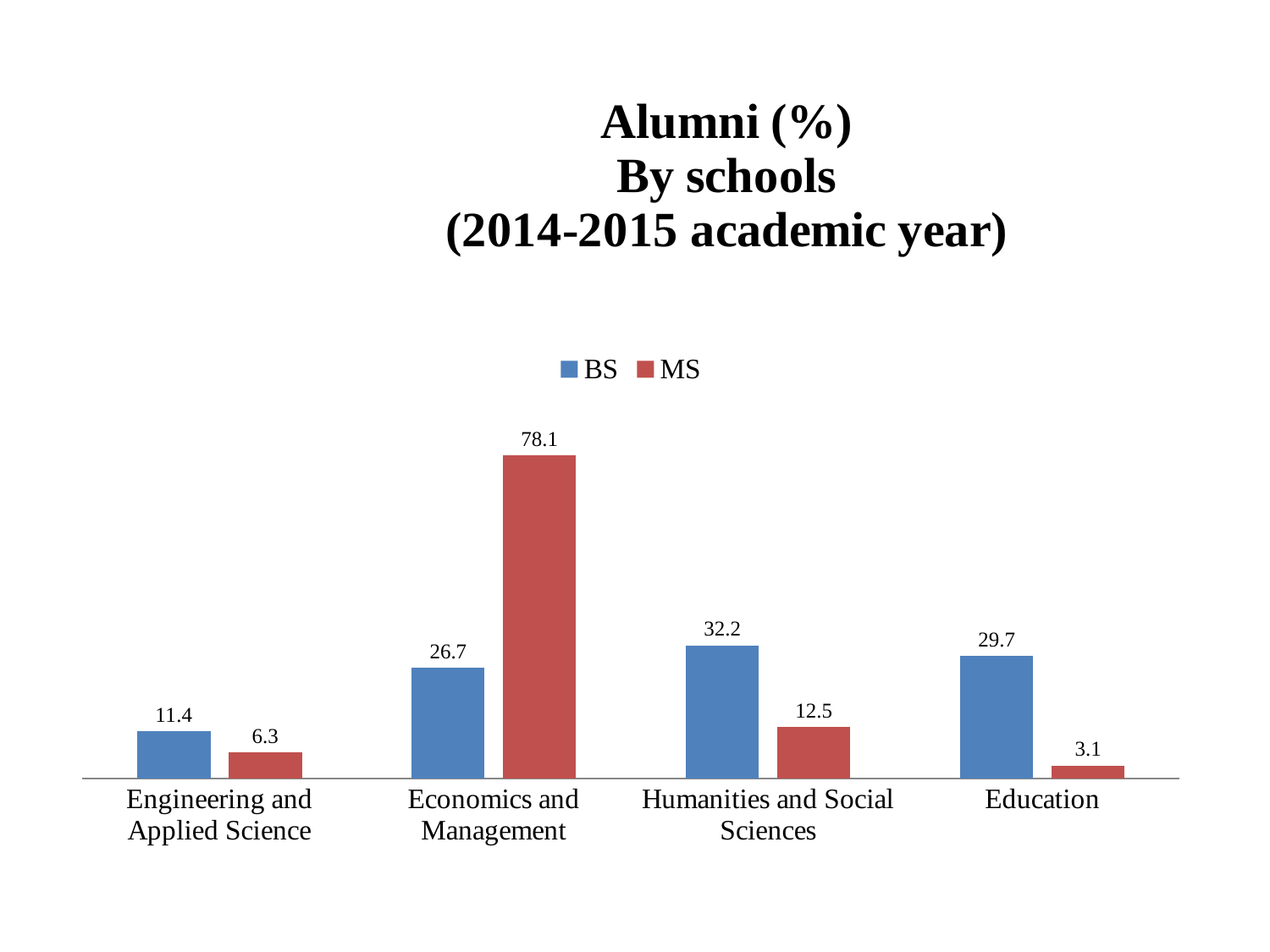
What is the BS value for Engineering and Applied Science? 11.4 How many series does the legend list? 2 Which school has the highest BS value? Humanities and Social Sciences What kind of chart is shown on the slide? Bar chart Which is larger for Humanities and Social Sciences, the BS value or the MS value? BS What is the difference between the MS and BS values for Economics and Management? 51.4 What is the difference between the BS values for Humanities and Social Sciences and Education? 2.5 What is the MS value for Education? 3.1 Which colour represents the MS series? Red What is the MS value for Economics and Management? 78.1 How many schools are shown on the x axis? 4 Which school has the lowest MS value? Education